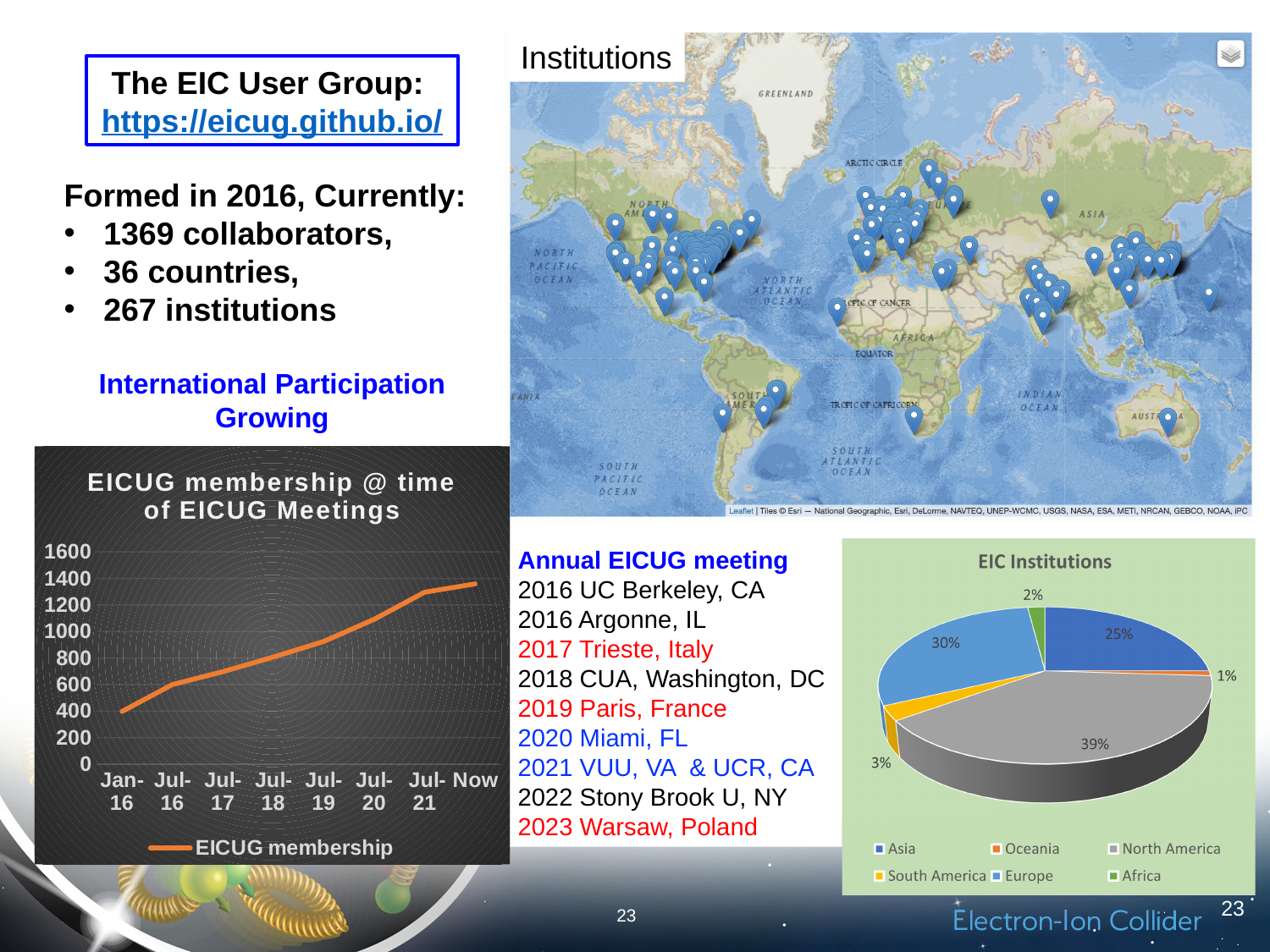
In the 'EICUG membership @ time of EICUG Meetings' chart, do the values rise or fall from Jan-16 to Now? Rise What type of chart is 'EIC Institutions'? Pie chart In the 'EIC Institutions' pie chart, what is the difference in percentage points between the North America and Europe shares? 9 In the 'EICUG membership @ time of EICUG Meetings' chart, how many points are plotted along the x axis? 8 In the 'EIC Institutions' pie chart, what share of institutions is from Europe? 30% In the 'EIC Institutions' pie chart, what share of institutions is from Asia? 25% In the 'EICUG membership @ time of EICUG Meetings' chart, is the value for Jul-20 greater or less than 1000? greater In the 'EIC Institutions' pie chart, how many regions are listed in the legend? 6 In the 'EIC Institutions' pie chart, which region has the largest share? North America What type of chart is 'EICUG membership @ time of EICUG Meetings'? Line chart In the 'EIC Institutions' pie chart, what share of institutions is from North America? 39% In the 'EIC Institutions' pie chart, which region has the smallest share? Oceania